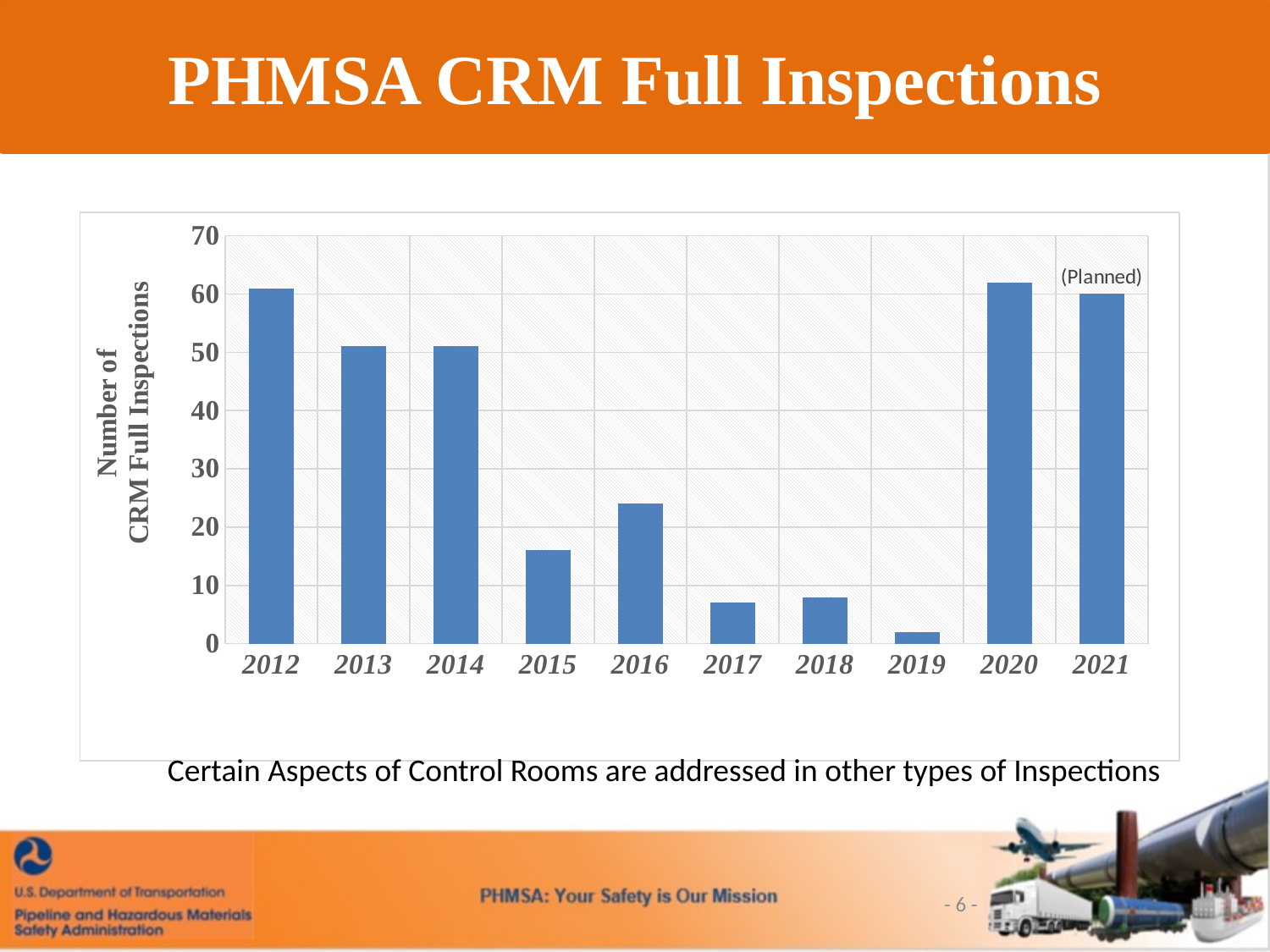
Which is larger, the value for 2016 or the value for 2017? 2016 Is the value for 2016 greater or less than 20? greater Is the value for 2015 greater or less than 20? less Is the value for 2020 greater or less than 60? greater Which year has the lowest number of CRM full inspections? 2019 How many years are shown on the x axis of the chart? 10 Do the values generally rise or fall from 2012 to 2019? fall What kind of chart is shown on the slide? bar chart Which year's bar is annotated as "(Planned)"? 2021 Which is larger, the value for 2012 or the value for 2015? 2012